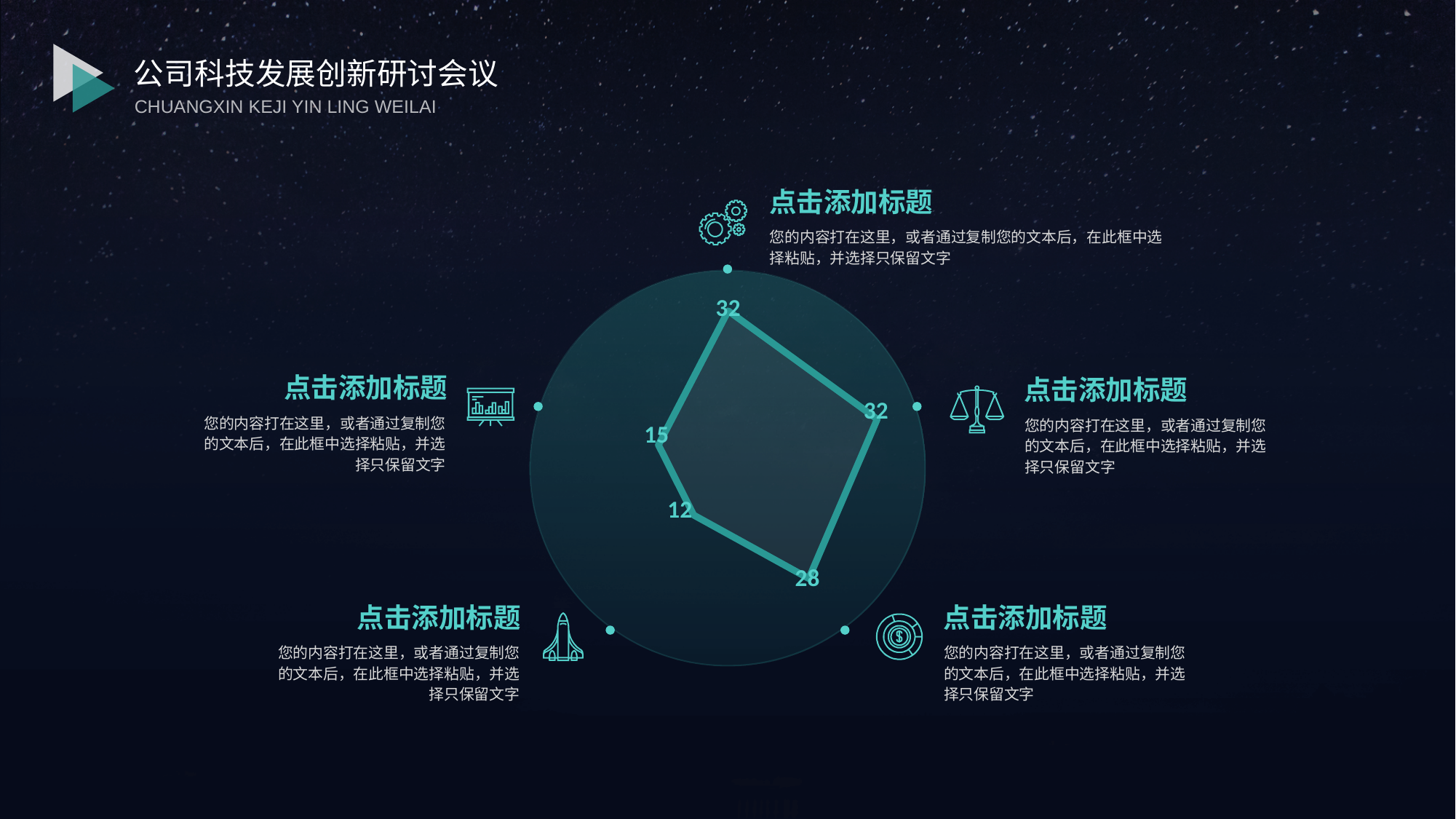
How many data points are plotted on the radar chart? 5 What is the difference between the topmost point (32) and the bottom-left point (12) on the radar chart? 20 What is the value of the point at the bottom right of the radar chart? 28 What is the value of the point on the left side of the radar chart? 15 What is the lowest value plotted on the radar chart? 12 What is the value of the topmost point on the radar chart? 32 What kind of chart is shown in the centre of the slide? radar chart What is the highest value plotted on the radar chart? 32 What is the value of the point at the bottom left of the radar chart? 12 What is the value of the point on the right side of the radar chart? 32 Which is larger on the radar chart: the bottom-right point or the left point? the bottom-right point (28) What is the difference between the bottom-right point (28) and the left point (15) on the radar chart? 13